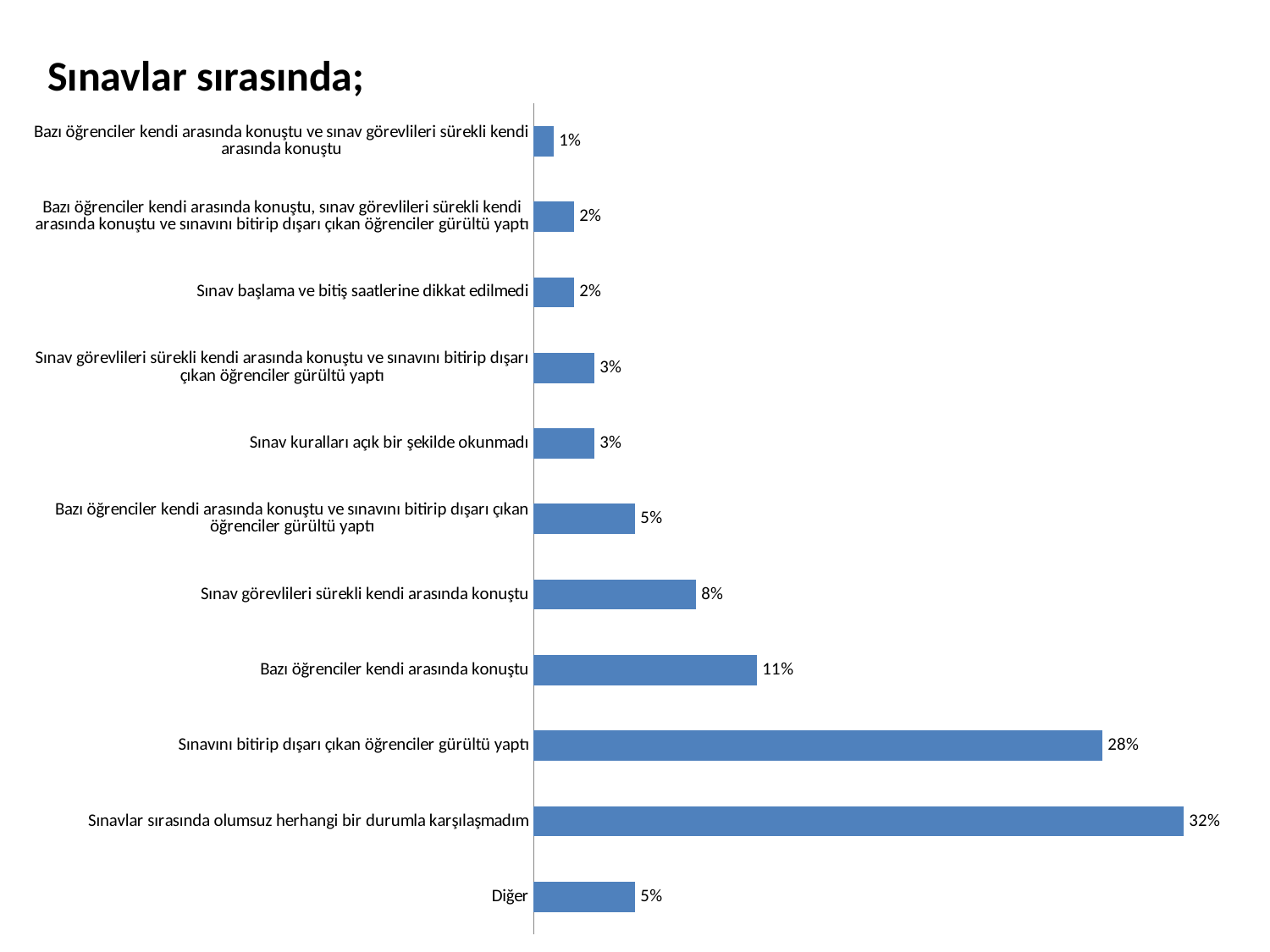
What kind of chart is shown on the slide? Bar chart Which category has the lowest value? Bazı öğrenciler kendi arasında konuştu ve sınav görevlileri sürekli kendi arasında konuştu How many categories are shown in the chart? 11 What is the value for "Bazı öğrenciler kendi arasında konuştu"? 11% Which category has the highest value? Sınavlar sırasında olumsuz herhangi bir durumla karşılaşmadım What is the value for "Diğer"? 5% What is the title of the slide? Sınavlar sırasında; What is the value for "Sınavlar sırasında olumsuz herhangi bir durumla karşılaşmadım"? 32% Which is larger: the value for "Bazı öğrenciler kendi arasında konuştu" or the value for "Sınav görevlileri sürekli kendi arasında konuştu"? Bazı öğrenciler kendi arasında konuştu What is the value for "Sınavını bitirip dışarı çıkan öğrenciler gürültü yaptı"? 28% What is the value for "Sınav görevlileri sürekli kendi arasında konuştu"? 8% What is the difference between the values for "Sınavlar sırasında olumsuz herhangi bir durumla karşılaşmadım" and "Sınavını bitirip dışarı çıkan öğrenciler gürültü yaptı"? 4%